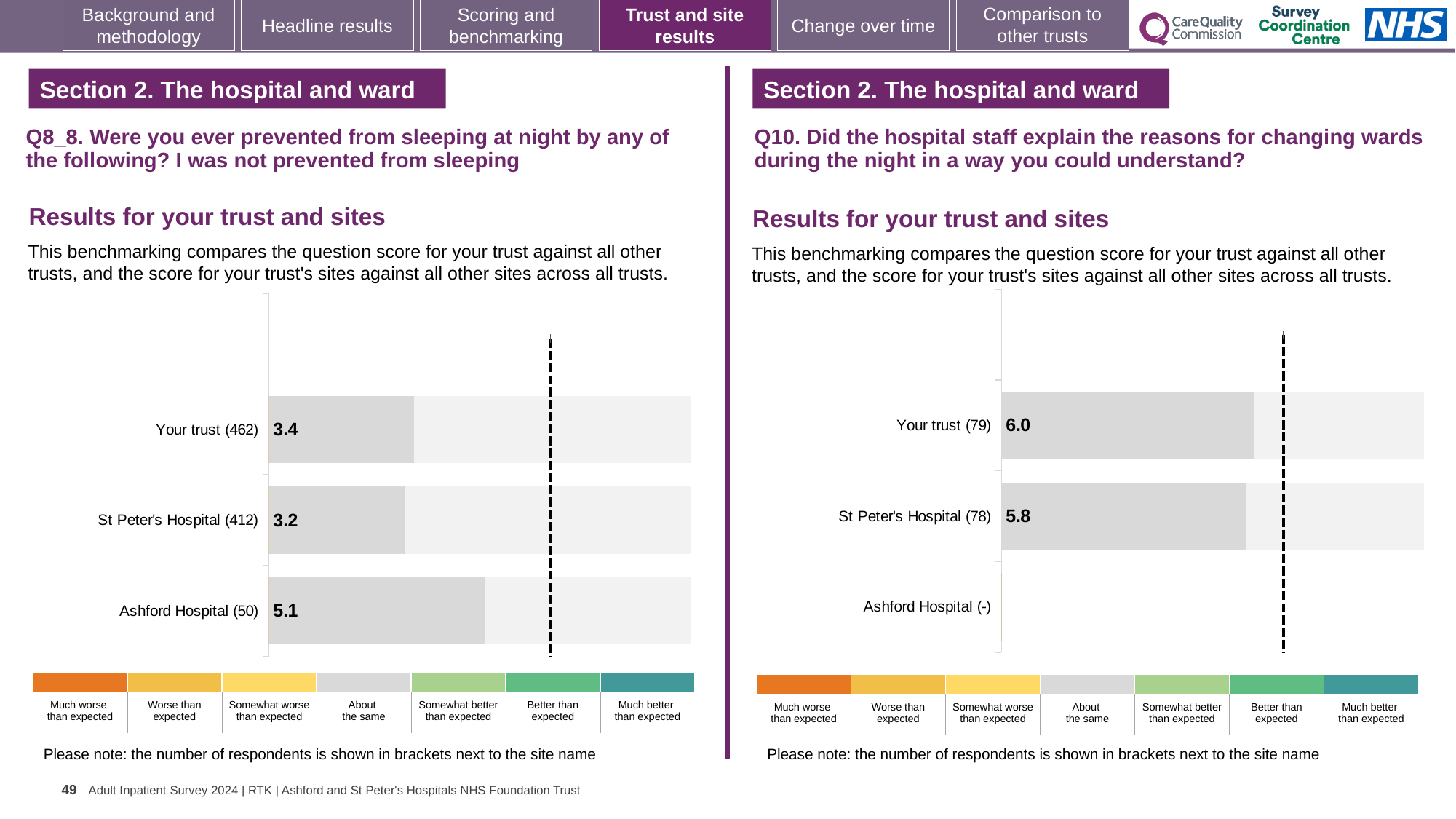
On the Q10 chart (right), what is the score for Your trust? 6.0 On the Q8_8 chart (left), what is the score for Your trust? 3.4 On the Q8_8 chart (left), what is the score for Ashford Hospital? 5.1 On the Q8_8 chart (left), which site or trust has the lowest score? St Peter's Hospital On the Q10 chart (right), what is the score for St Peter's Hospital? 5.8 On the Q10 chart (right), how many respondents are shown for St Peter's Hospital? 78 On the Q8_8 chart (left), which site or trust has the highest score? Ashford Hospital What kind of chart is used on the Q8_8 chart (left)? Bar chart On the Q8_8 chart (left), how many respondents are shown for Your trust? 462 On the Q10 chart (right), what is the difference between the scores for Your trust and St Peter's Hospital? 0.2 On the Q8_8 chart (left), what is the score for St Peter's Hospital? 3.2 On the Q8_8 chart (left), what is the difference between the scores for Ashford Hospital and St Peter's Hospital? 1.9